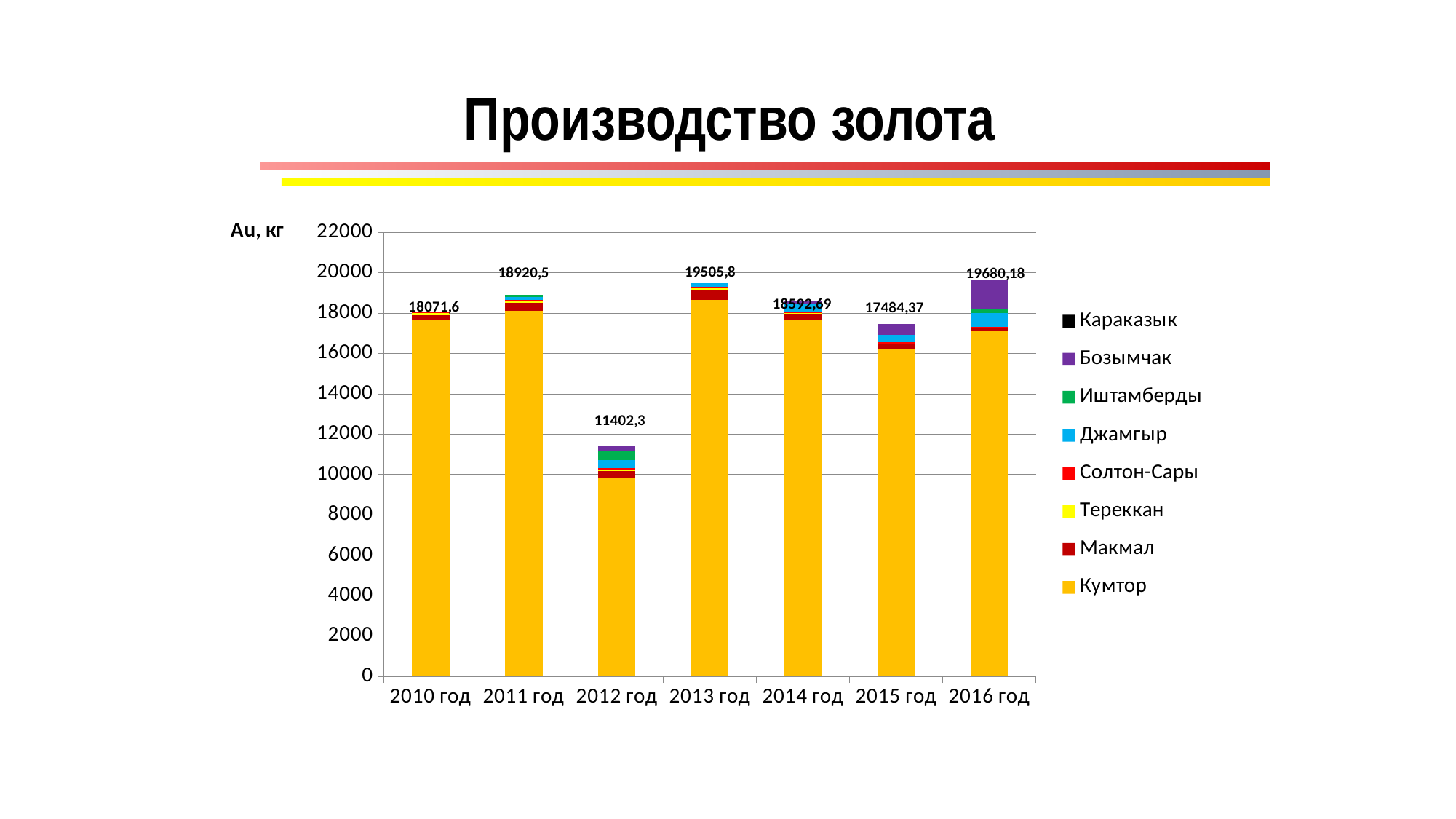
What is the total value shown above the bar for 2012 год? 11402,3 Which year has the highest total gold production? 2016 год Is the Кумтор value for 2016 год greater or less than 16000? greater Which year has the lowest total gold production? 2012 год How many years are shown on the x axis? 7 Which year has the larger total: 2014 год or 2015 год? 2014 год What kind of chart is shown on the slide? Stacked bar chart What is the difference between the total for 2013 год and the total for 2012 год? 8103,5 What is the difference between the total for 2011 год and the total for 2010 год? 848,9 How many series does the legend list? 8 Do the total values rise or fall from 2013 год to 2015 год? fall What is the total gold production labelled for 2013 год? 19505,8